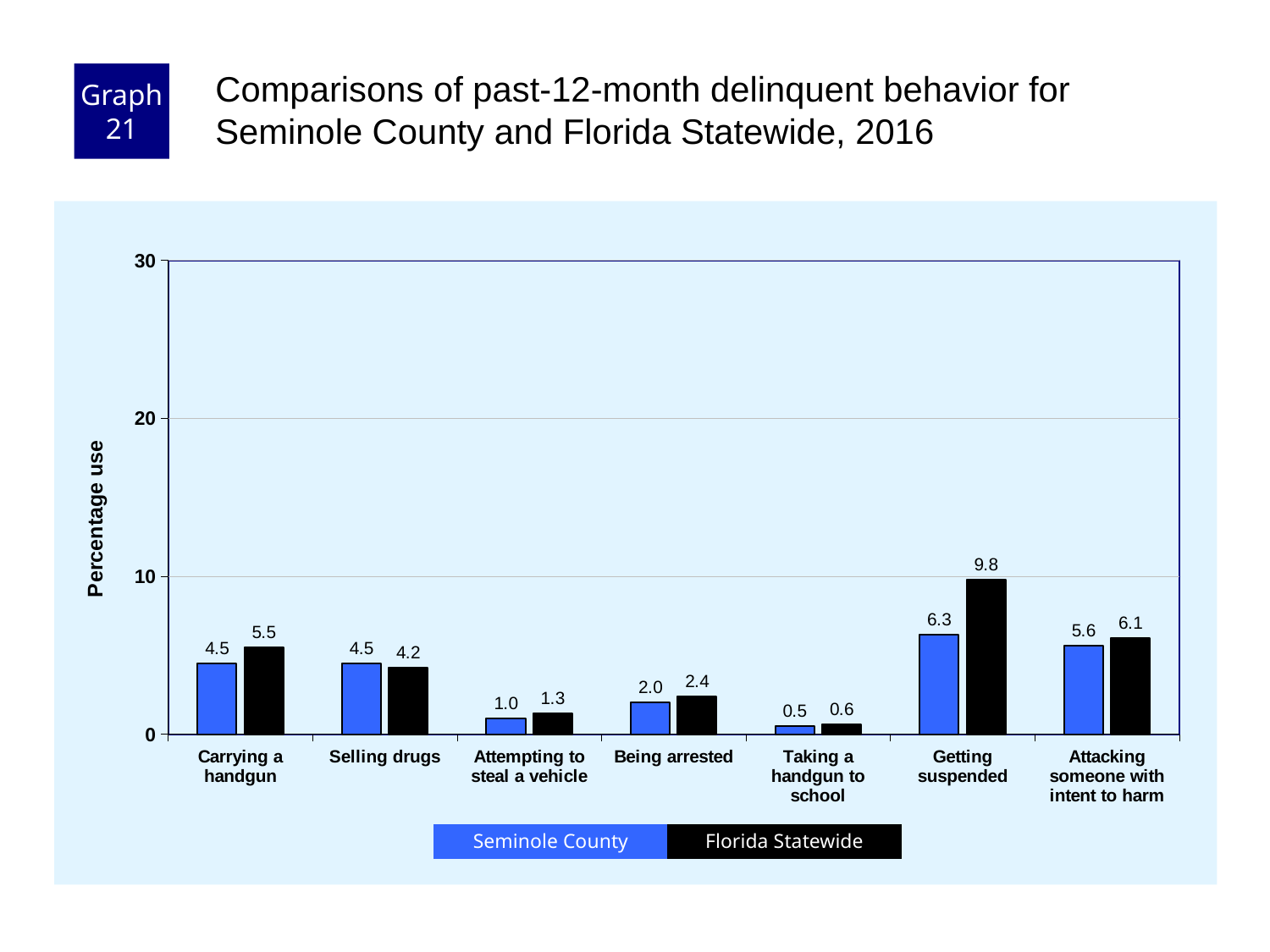
What is the Seminole County value for Taking a handgun to school? 0.5 What is the Seminole County value for Getting suspended? 6.3 What is the difference between the Florida Statewide and Seminole County values for Getting suspended? 3.5 What is the Florida Statewide value for Carrying a handgun? 5.5 What is the label of the y axis? Percentage use What kind of chart is shown on the slide? bar chart Is the Florida Statewide value for Getting suspended greater or less than 10? less Which category has the lowest Seminole County value? Taking a handgun to school For Selling drugs, which is larger: the Seminole County value or the Florida Statewide value? Seminole County How many series does the legend list? 2 How many categories are shown on the x axis? 7 Which category has the highest Florida Statewide value? Getting suspended